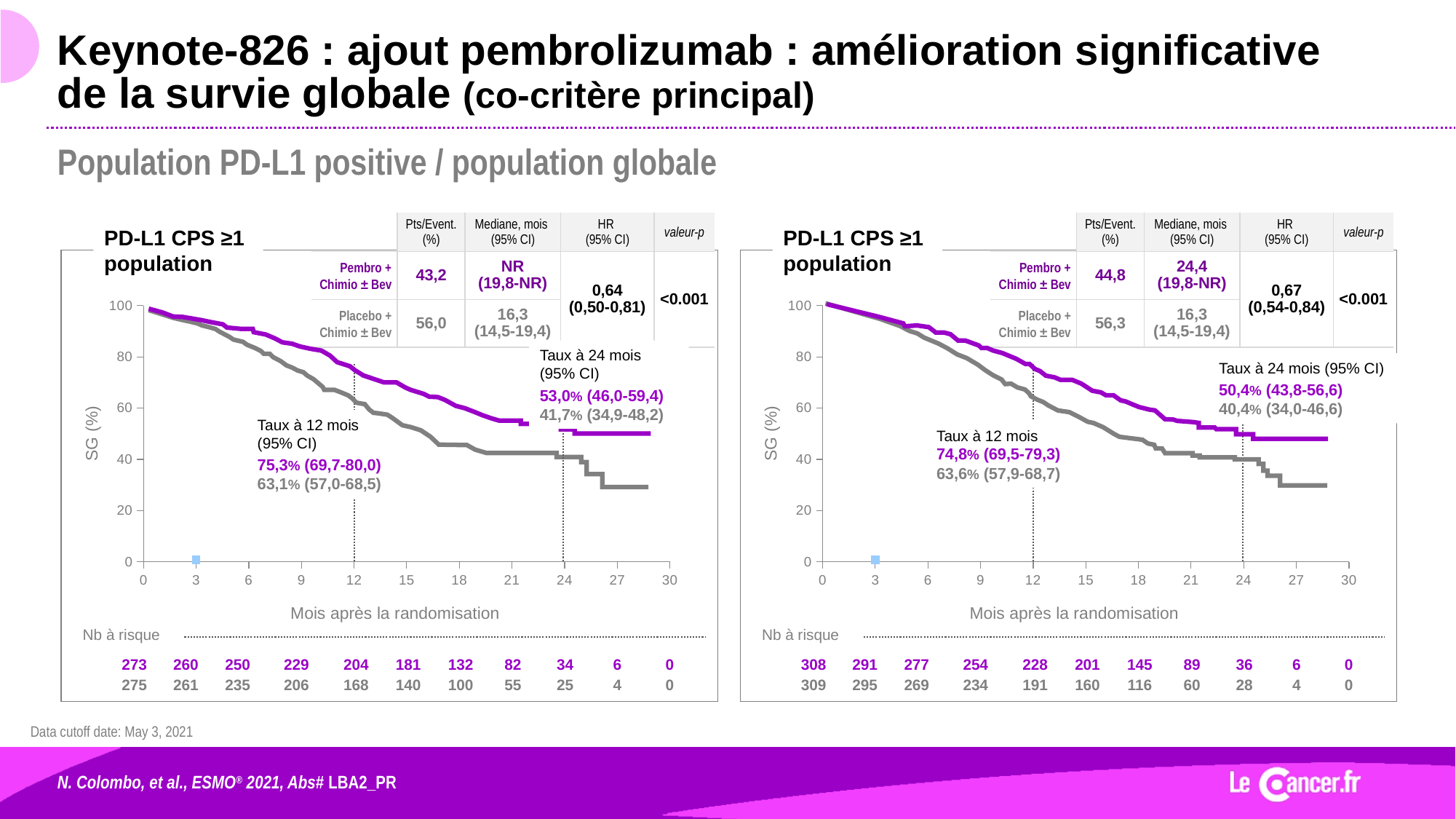
In the left chart, how many patients were at risk in the Placebo arm at 18 months? 100 In the left chart, what is the 24-month overall survival rate for the Placebo + Chimio ± Bev arm? 41,7% What kind of chart is shown on the left of the slide? Line chart (Kaplan-Meier survival curve) In the right chart, what is the median overall survival in months for the Pembro + Chimio ± Bev arm? 24,4 (19,8-NR) In the right chart, what is the 24-month survival rate for the Pembro + Chimio ± Bev arm? 50,4% In the left chart, what is the hazard ratio (95% CI) shown in the table? 0,64 (0,50-0,81) In the left chart, do the survival curves rise or fall as months after randomisation increase? Fall In the left chart, what is the difference between the 12-month survival rates of the Pembro arm (75,3%) and the Placebo arm (63,1%)? 12,2 percentage points In the left chart, what is the 12-month overall survival rate for the Pembro + Chimio ± Bev arm? 75,3% In the right chart, is the value of the purple (Pembro) curve at 6 months greater or less than 80? greater In the right chart, how many patients were at risk in the Pembro arm at 12 months? 228 In the right chart, which arm has the higher 12-month survival rate, Pembro + Chimio ± Bev or Placebo + Chimio ± Bev? Pembro + Chimio ± Bev